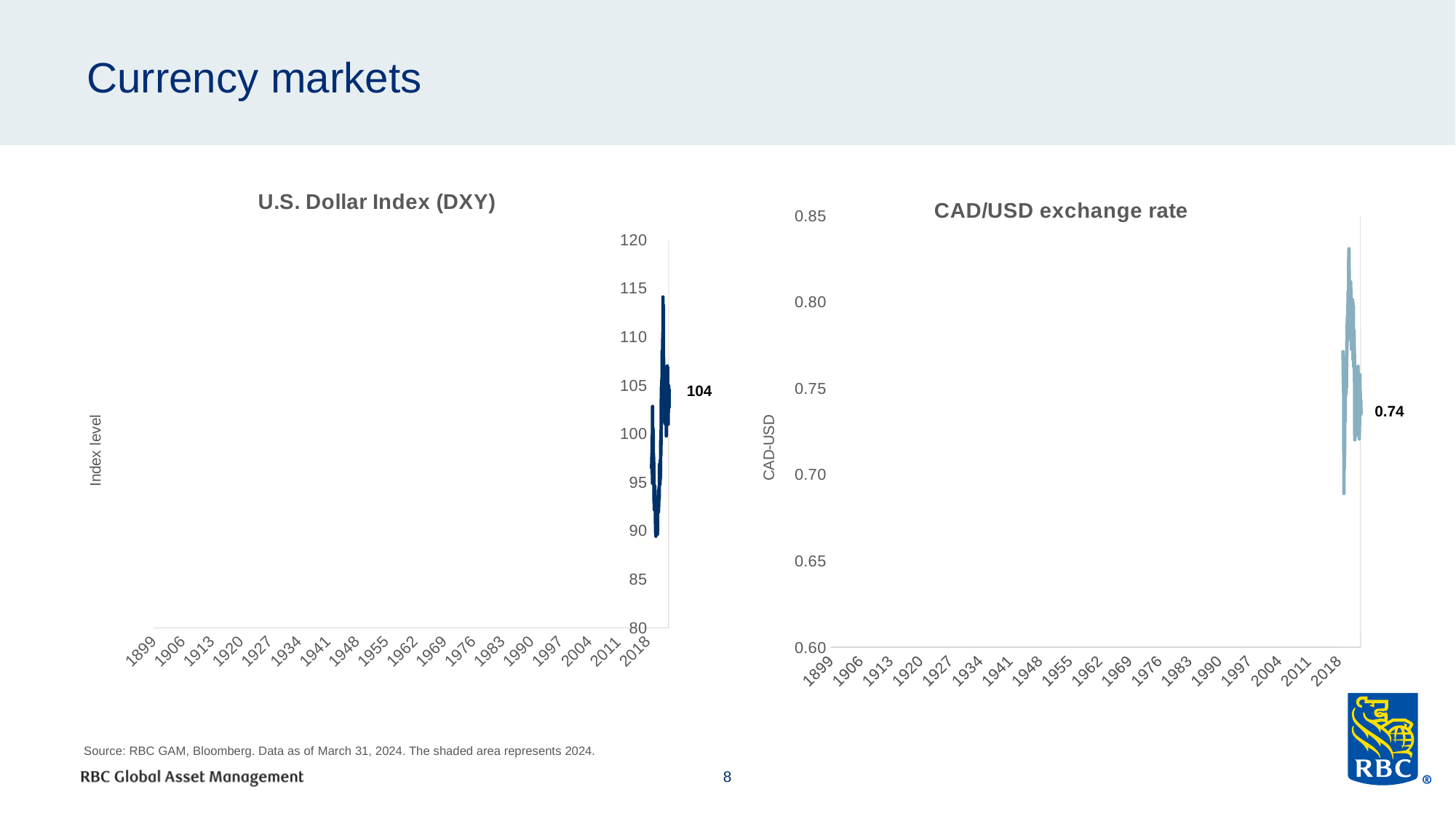
On the U.S. Dollar Index (DXY) chart, is the latest labelled value greater or less than 100? greater On the CAD/USD exchange rate chart, what is the latest value shown by the data label? 0.74 On the U.S. Dollar Index (DXY) chart, is the lowest point of the line greater or less than 95? less What is the y-axis label on the U.S. Dollar Index (DXY) chart? Index level On the CAD/USD exchange rate chart, is the highest point of the line greater or less than 0.80? greater What kind of chart is the U.S. Dollar Index (DXY) chart? Line chart What kind of chart is the CAD/USD exchange rate chart? Line chart What is the y-axis label on the CAD/USD exchange rate chart? CAD-USD On the U.S. Dollar Index (DXY) chart, what is the latest value shown by the data label? 104